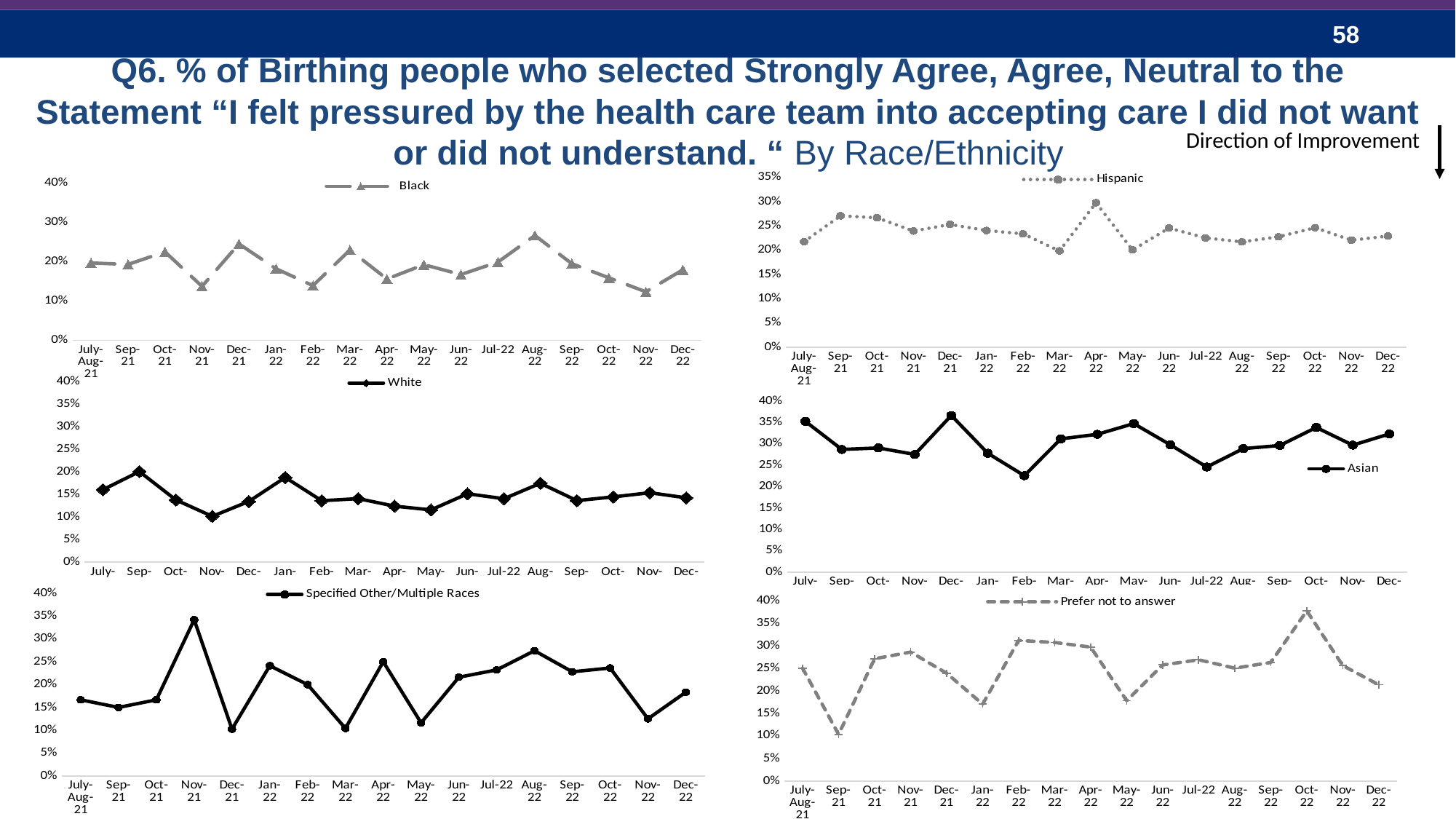
In the "Specified Other/Multiple Races" chart, is the value for Nov-21 greater or less than 30%? greater In the "Specified Other/Multiple Races" chart, which month has the highest value? Nov-21 In the "Prefer not to answer" chart, which month has the lowest value? Sep-21 What kind of chart is the chart titled "Black" in the legend? line chart In the "Prefer not to answer" chart, which month has the highest value? Oct-22 In the "Asian" chart, is the value for Feb-22 greater or less than 25%? less How many data points are plotted in the "Black" chart? 17 In the "Hispanic" chart, which month has the highest value? Apr-22 In the "Black" chart, is the value for Aug-22 greater or less than 20%? greater How many series does the legend of the bottom-right chart list? 1